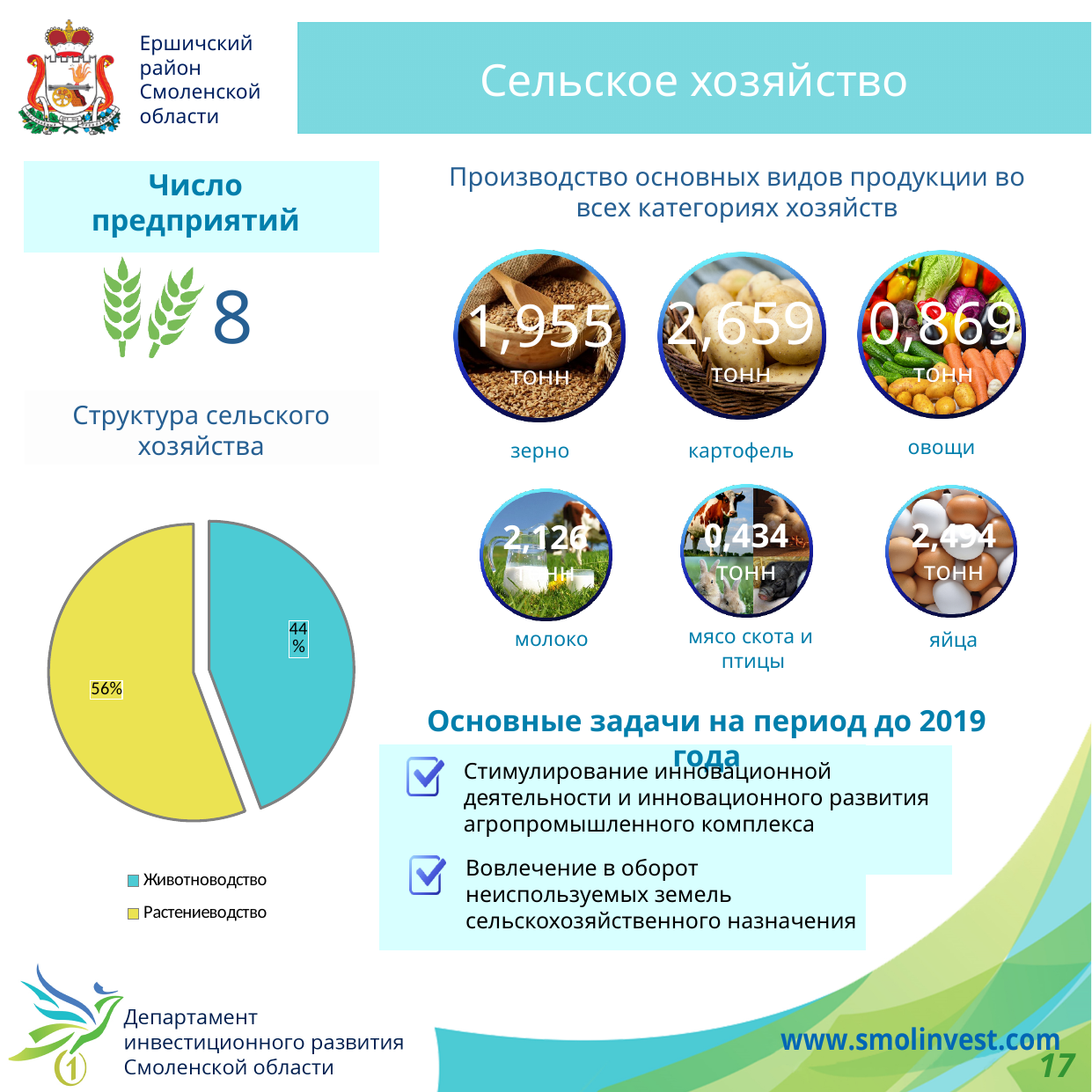
In the pie chart "Структура сельского хозяйства", which category has the smallest slice? Животноводство In the pie chart "Структура сельского хозяйства", what colour is the Животноводство slice? cyan In the pie chart "Структура сельского хозяйства", what share does Растениеводство have? 56% In the pie chart "Структура сельского хозяйства", what share does Животноводство have? 44% What kind of chart is shown under "Структура сельского хозяйства"? pie chart In the pie chart "Структура сельского хозяйства", what colour is the Растениеводство slice? yellow How many entries does the legend of the pie chart "Структура сельского хозяйства" list? 2 In the pie chart "Структура сельского хозяйства", which category has the largest slice? Растениеводство In the pie chart "Структура сельского хозяйства", which is larger: Животноводство or Растениеводство? Растениеводство In the pie chart "Структура сельского хозяйства", what is the difference in percentage points between Растениеводство and Животноводство? 12 In the pie chart "Структура сельского хозяйства", what is the total of the two slices' shares? 100% How many slices does the pie chart "Структура сельского хозяйства" have? 2